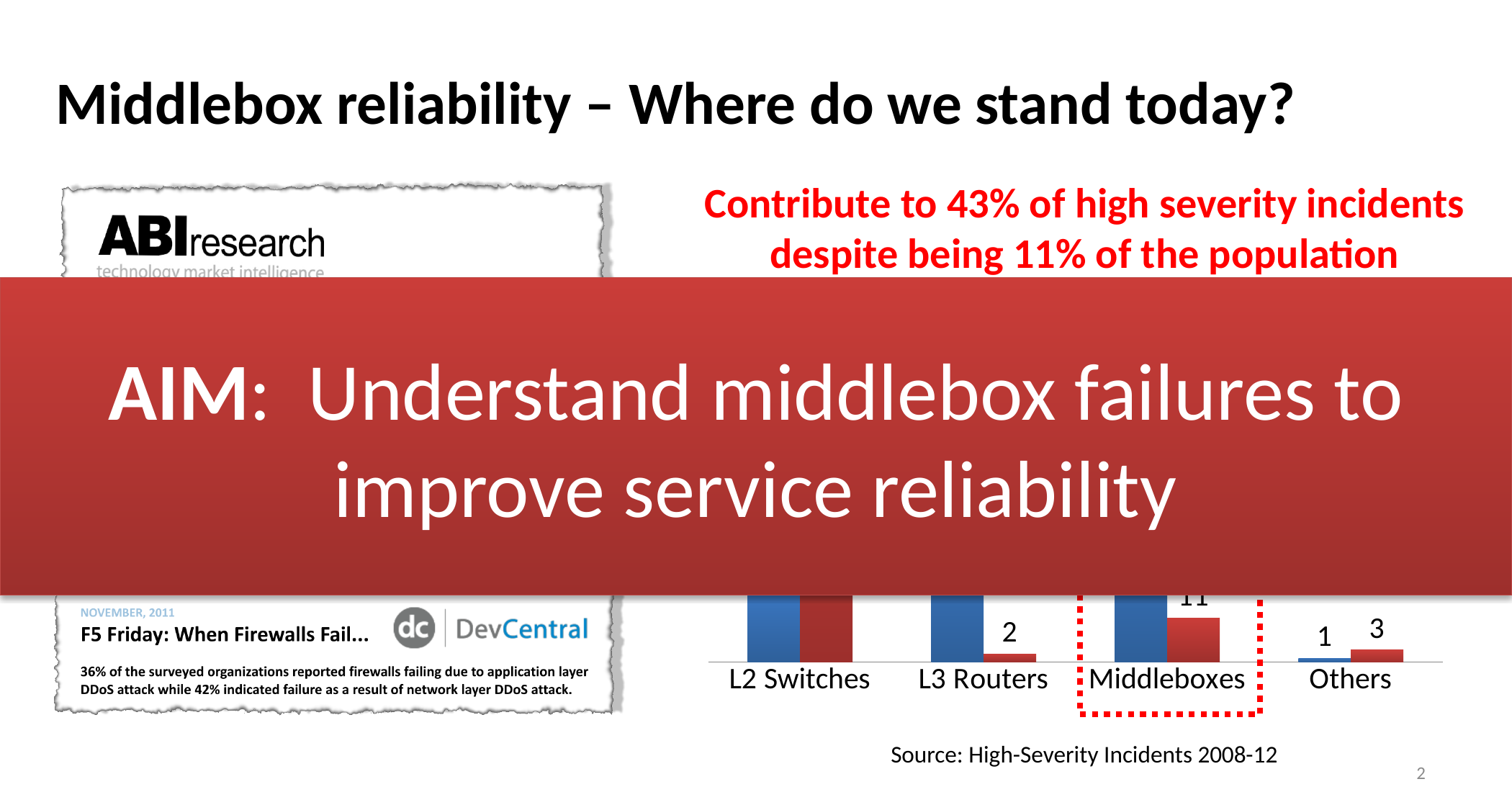
Which category on the chart is highlighted with a dotted red box? Middleboxes What is the difference between the red bar and the blue bar for Others? 2 What is the value of the red bar for Middleboxes in the chart? 11 For Others, which bar is larger, the blue bar or the red bar? the red bar What source is cited below the chart? High-Severity Incidents 2008-12 Which has a larger red bar, L3 Routers or Others? Others What kind of chart is shown on the slide? bar chart How many series of bars (colours) are plotted for each category in the chart? 2 What is the value of the blue bar for Others in the chart? 1 What is the value of the red bar for L3 Routers in the chart? 2 What is the value of the red bar for Others in the chart? 3 How many categories are shown on the x axis of the chart? 4